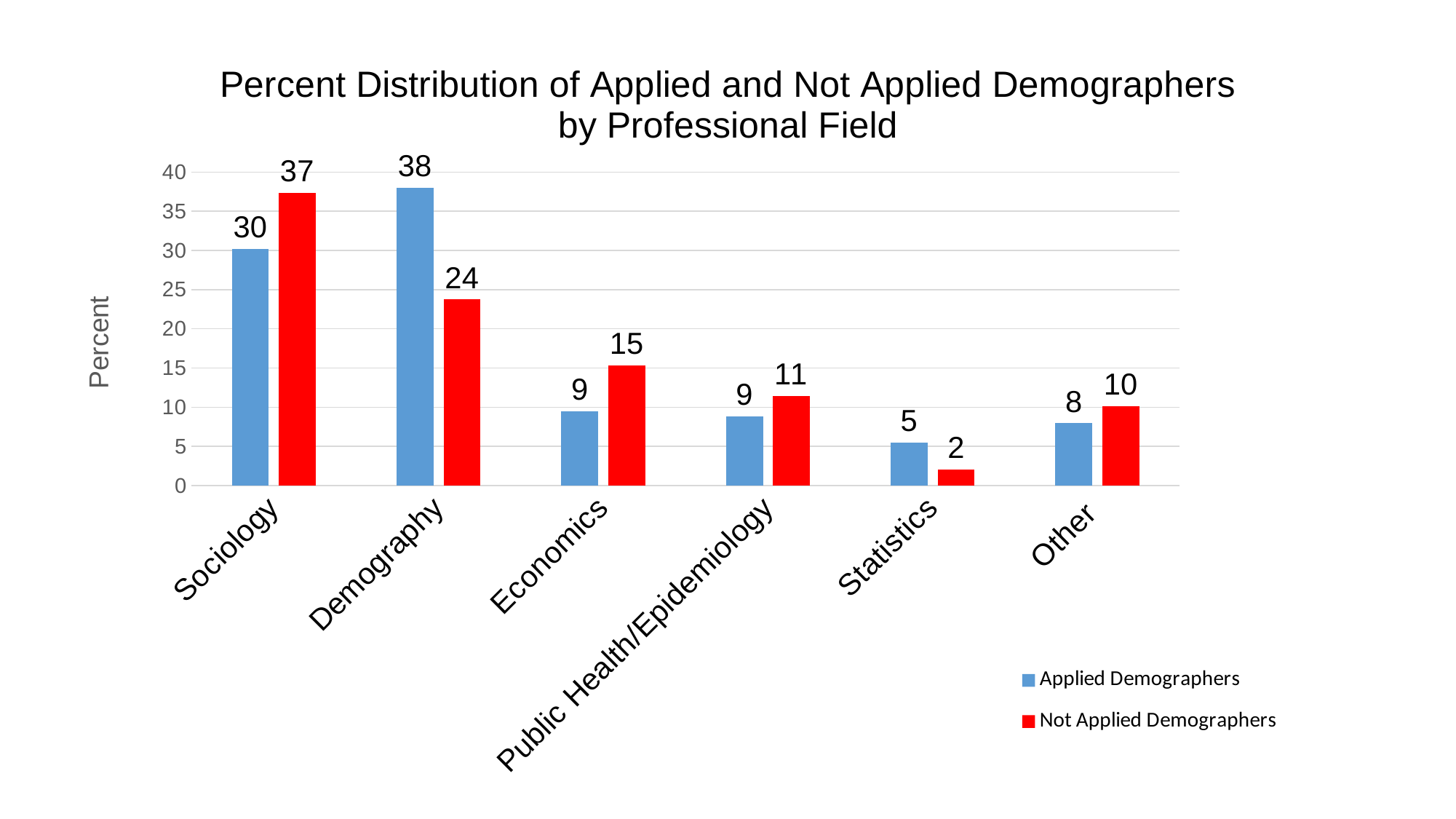
How many series does the legend list? 2 What is the value for Applied Demographers in Demography? 38 Which is larger for Economics: Applied Demographers or Not Applied Demographers? Not Applied Demographers What is the value for Not Applied Demographers in Sociology? 37 Which professional field has the highest value for Applied Demographers? Demography What is the difference between the Applied Demographers and Not Applied Demographers values for Demography? 14 What kind of chart is shown on the slide? Bar chart What is the label of the vertical axis? Percent Which professional field has the lowest value for Not Applied Demographers? Statistics What is the value for Not Applied Demographers in Statistics? 2 How many professional fields are shown on the x axis? 6 Is the value for Applied Demographers in Sociology greater or less than 25? greater